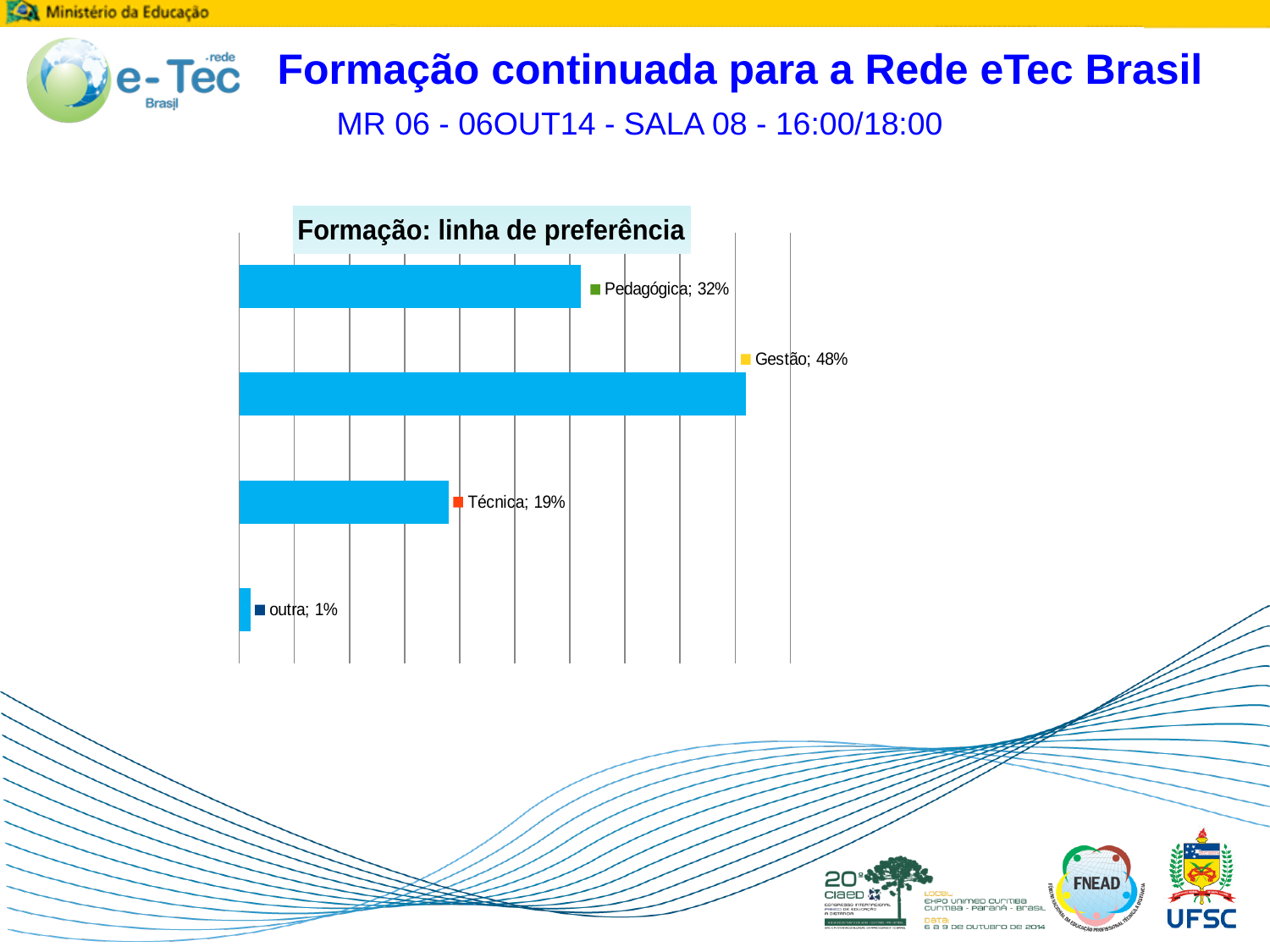
What is the difference between the values for Pedagógica and Técnica? 13% What is the value for Pedagógica in the chart? 32% Which category has the highest value? Gestão What is the value for Técnica in the chart? 19% How many categories are shown in the chart? 4 What is the title of the chart? Formação: linha de preferência Which category has the lowest value? outra What is the value for outra in the chart? 1% Which is larger, the value for Técnica or the value for Pedagógica? Pedagógica What kind of chart is shown on the slide? Bar chart What is the value for Gestão in the chart? 48% What is the difference between the values for Gestão and Pedagógica? 16%